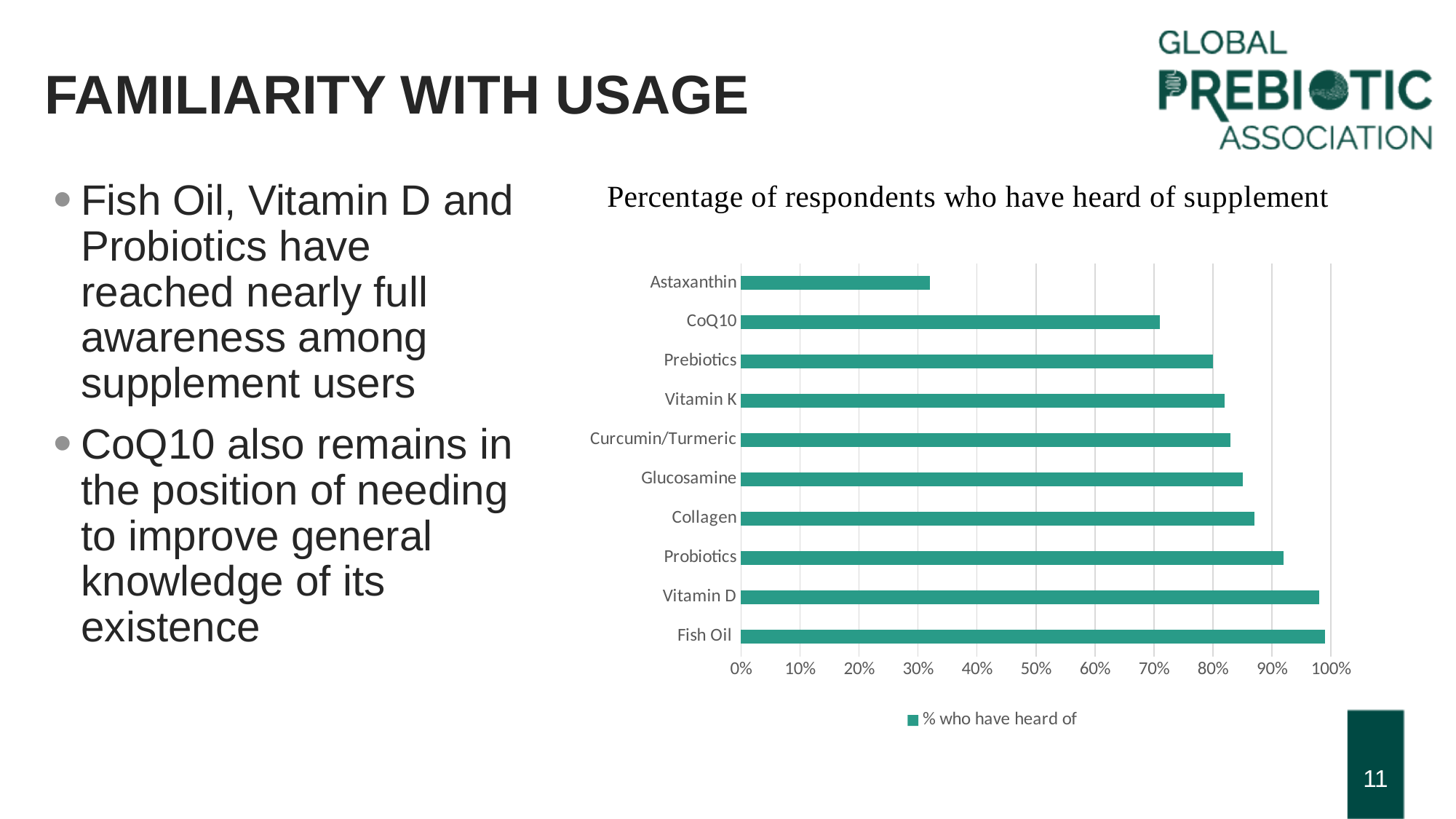
What is the legend entry shown below the chart? % who have heard of Is the value for CoQ10 greater or less than 60%? greater Which has a higher value, Astaxanthin or CoQ10? CoQ10 Which supplement has the lowest percentage of respondents who have heard of it? Astaxanthin Which has a higher value, Prebiotics or Probiotics? Probiotics Is the value for Glucosamine greater or less than 90%? less Is the value for Vitamin D greater or less than 90%? greater How many supplements are listed on the chart? 10 What is the title of the chart? Percentage of respondents who have heard of supplement What kind of chart is shown on the slide? bar chart How many series does the chart legend list? 1